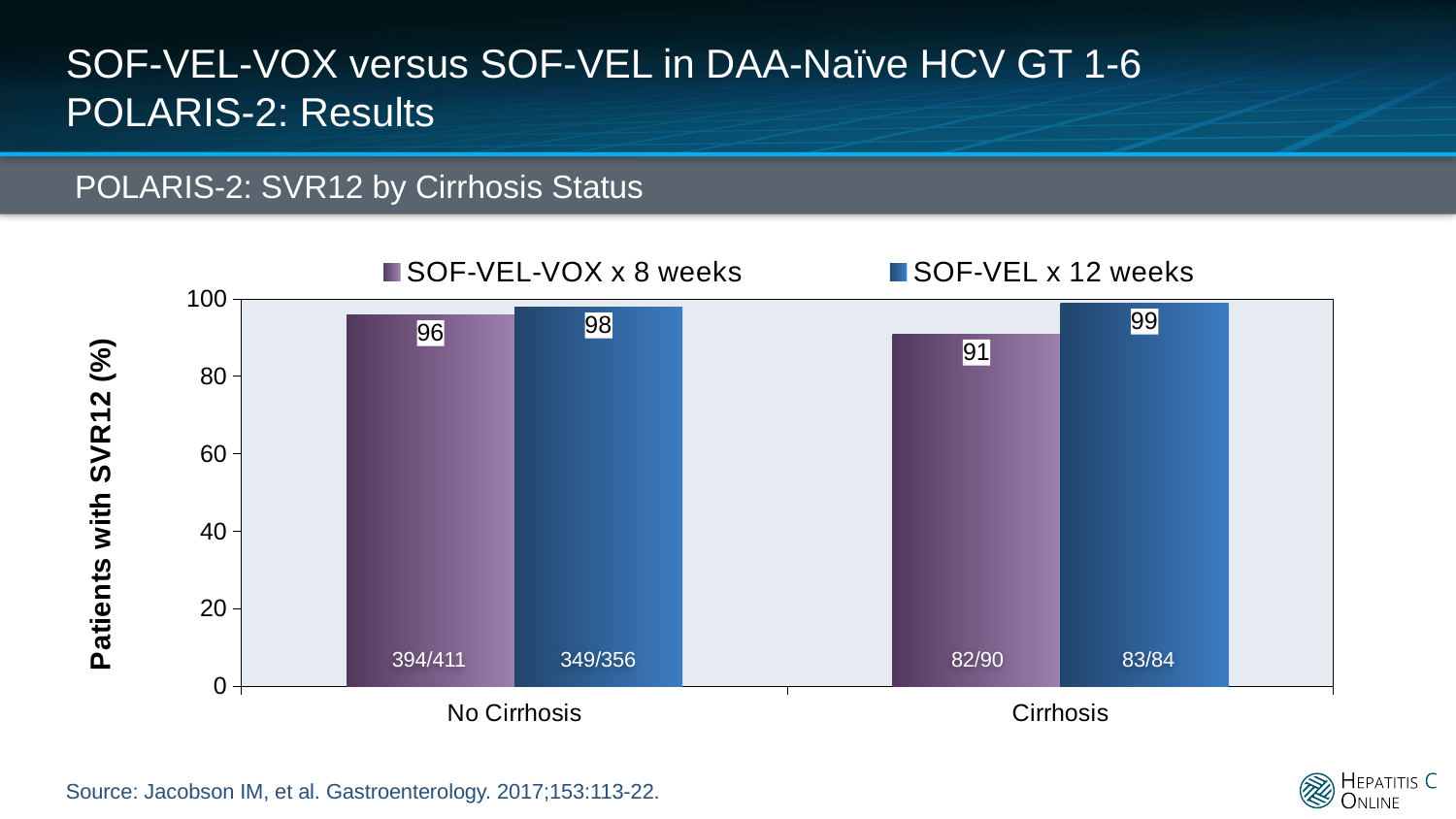
How many series does the legend list? 2 In the No Cirrhosis group, which regimen has the higher SVR12 rate? SOF-VEL x 12 weeks What fraction of patients is shown for SOF-VEL x 12 weeks in the Cirrhosis group? 83/84 What is the SVR12 rate for SOF-VEL-VOX x 8 weeks in the Cirrhosis group? 91 What is the difference in SVR12 rate between SOF-VEL x 12 weeks and SOF-VEL-VOX x 8 weeks in the Cirrhosis group? 8 Which bar has the highest SVR12 rate? SOF-VEL x 12 weeks, Cirrhosis What is the SVR12 rate for SOF-VEL x 12 weeks in the No Cirrhosis group? 98 How many cirrhosis status categories are shown on the x axis? 2 What type of chart is shown? Bar chart Which bar has the lowest SVR12 rate? SOF-VEL-VOX x 8 weeks, Cirrhosis What is the SVR12 rate for SOF-VEL-VOX x 8 weeks in the No Cirrhosis group? 96 What is the SVR12 rate for SOF-VEL x 12 weeks in the Cirrhosis group? 99